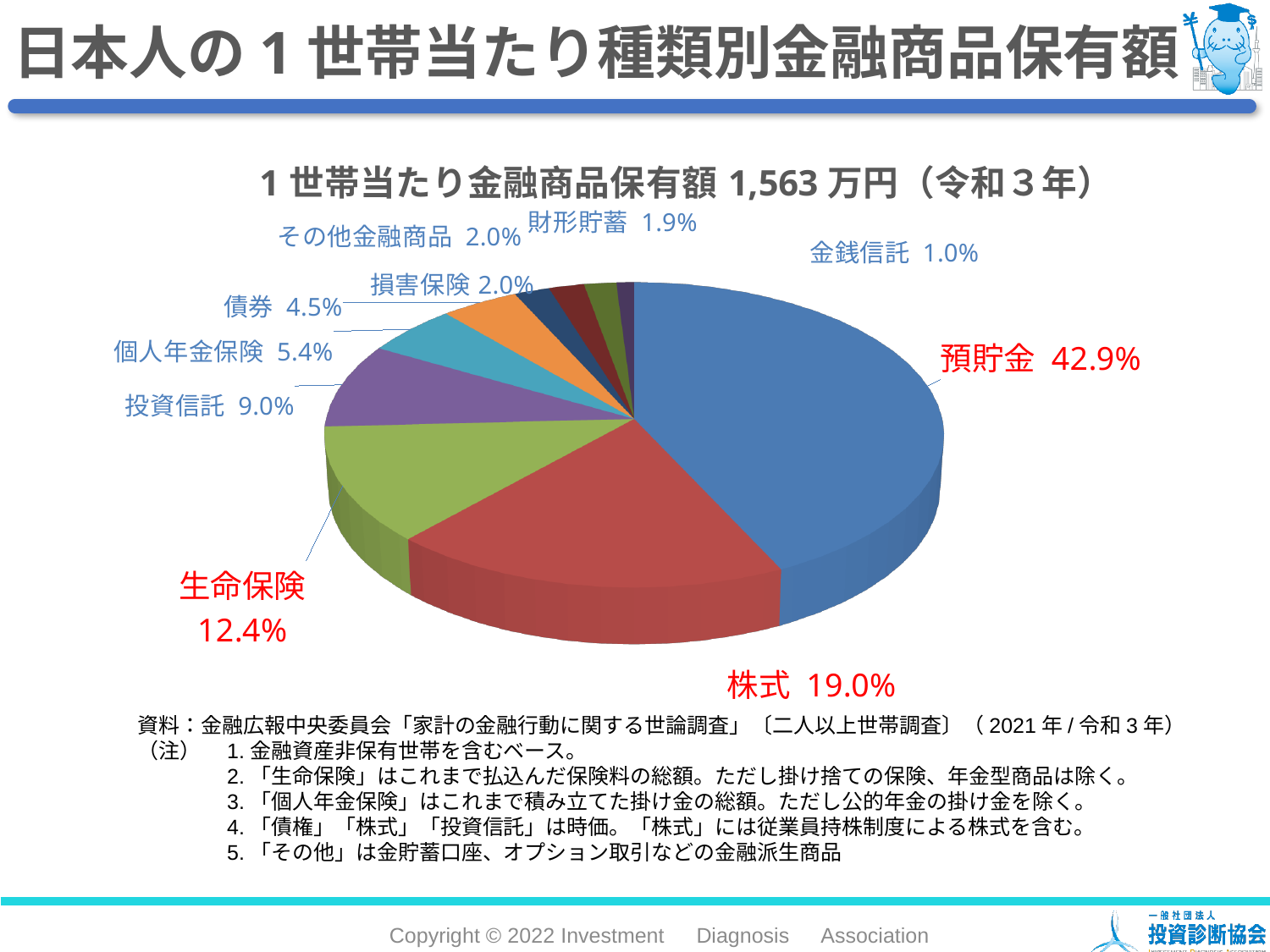
What share of the pie does 預貯金 hold? 42.9% What total amount per household is stated in the chart title? 1,563 万円 How many categories (slices) are shown in the pie chart? 10 Which category has the largest share of the pie? 預貯金 What is the difference between the shares of 預貯金 and 株式? 23.9% What type of chart is shown on the slide? Pie chart Which category has the smallest share of the pie? 金銭信託 Which is larger, the share of 債券 or the share of 個人年金保険? 個人年金保険 What is the value shown for 生命保険? 12.4% What is the value shown for 株式? 19.0% What is the value shown for 投資信託? 9.0% What is the value shown for 個人年金保険? 5.4%